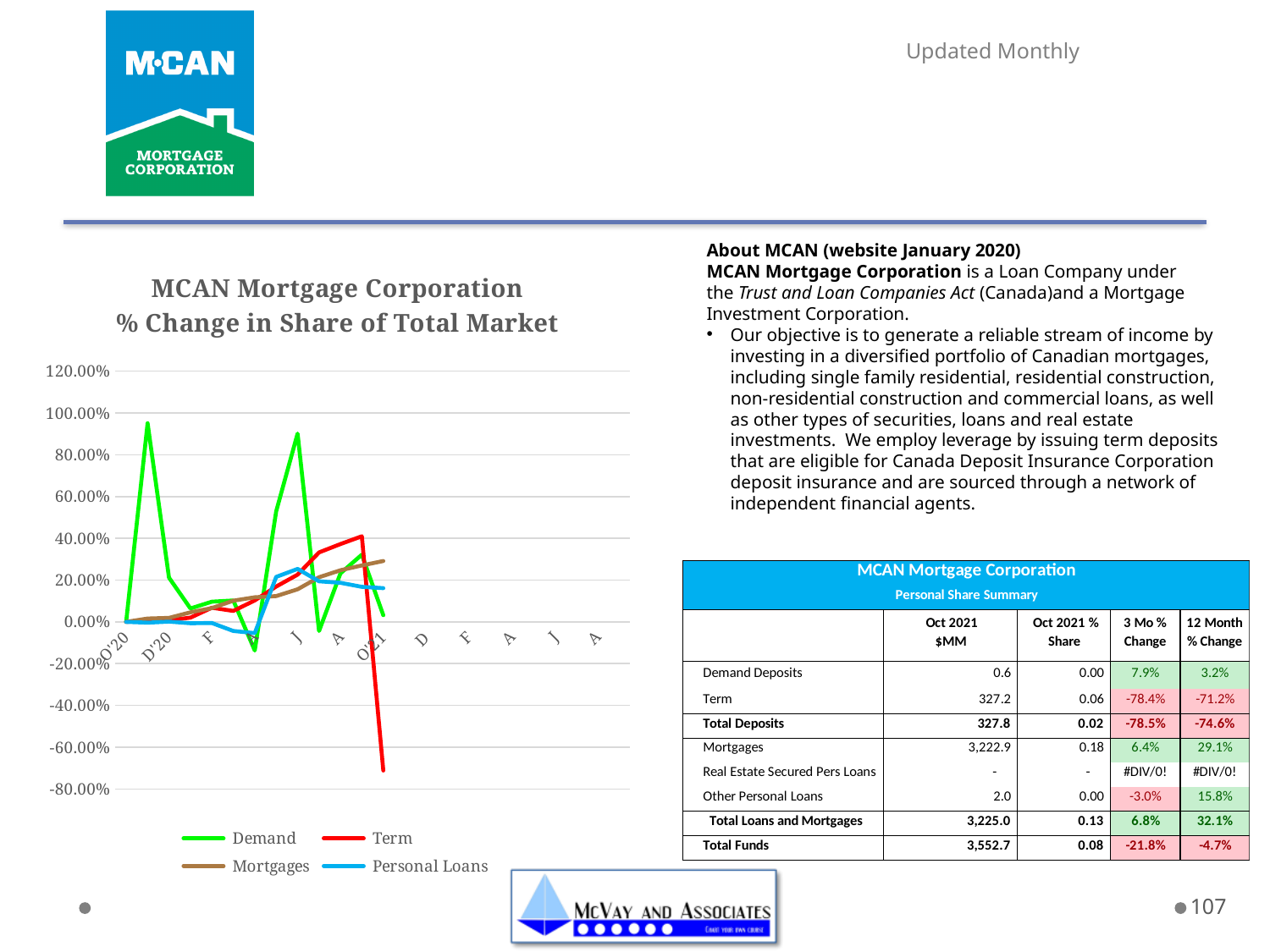
What is the title of the chart? MCAN Mortgage Corporation % Change in Share of Total Market Is the peak value of the Demand series greater or less than 80.00%? greater Around D'20, which series is higher: Demand or Term? Demand Does the Term series rise or fall at the end of the plotted period? fall What kind of chart is shown on the slide? line chart At the last plotted point, which series is higher: Term or Mortgages? Mortgages How many series does the chart legend list? 4 Is the final value of the Mortgages series greater or less than 20.00%? greater Which series is drawn in green in the chart? Demand Is the lowest value of the Term series greater or less than -60.00%? less Which series reaches the lowest value on the chart? Term Which series reaches the highest value on the chart? Demand